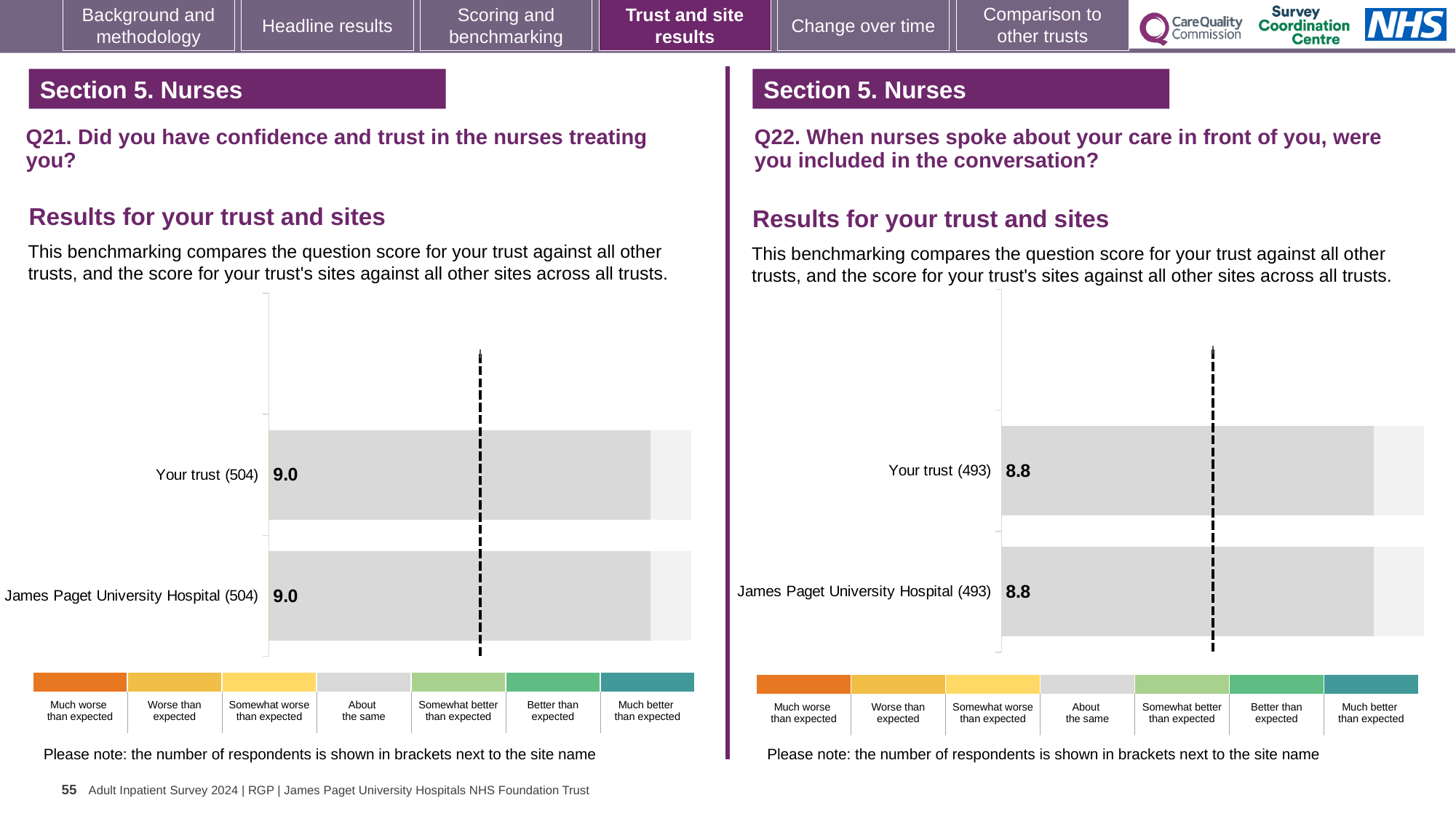
On the Q22 chart (right), what is the difference between the score for Your trust and the score for James Paget University Hospital? 0.0 On the Q21 chart (left), what is the score for Your trust? 9.0 How many bars are plotted on the Q22 chart (right)? 2 What kind of chart is used on the Q22 chart (right)? Bar chart On the Q22 chart (right), what is the score for James Paget University Hospital? 8.8 On the Q21 chart (left), what is the difference between the score for Your trust and the score for James Paget University Hospital? 0.0 How many bars are plotted on the Q21 chart (left)? 2 On the Q21 chart (left), what is the score for James Paget University Hospital? 9.0 On the Q21 chart (left), how many respondents are shown in brackets next to Your trust? 504 On the Q22 chart (right), what is the score for Your trust? 8.8 On the Q22 chart (right), how many respondents are shown in brackets next to James Paget University Hospital? 493 Is the score for Your trust on the Q21 chart (left) larger or smaller than the score for Your trust on the Q22 chart (right)? Larger